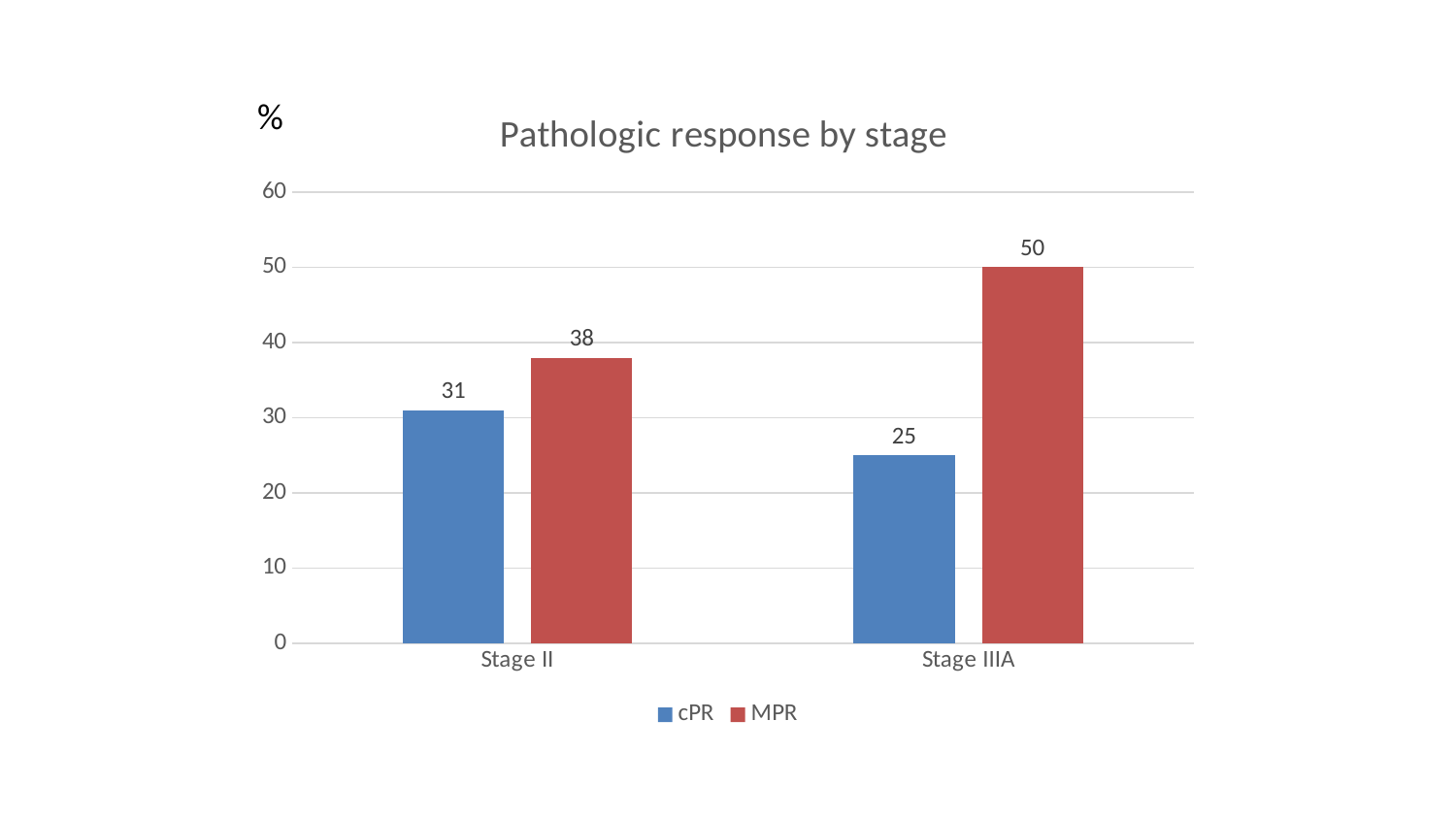
How many series does the legend list? 2 What is the cPR value for Stage II? 31 Which stage has the highest MPR value? Stage IIIA Which is larger, the cPR value for Stage II or the cPR value for Stage IIIA? Stage II What is the difference between the MPR values for Stage IIIA and Stage II? 12 How many stages are shown on the x axis? 2 What is the MPR value for Stage IIIA? 50 What is the cPR value for Stage IIIA? 25 Which stage has the lowest cPR value? Stage IIIA What is the difference between the MPR and cPR values for Stage IIIA? 25 What is the title of the chart? Pathologic response by stage What is the MPR value for Stage II? 38